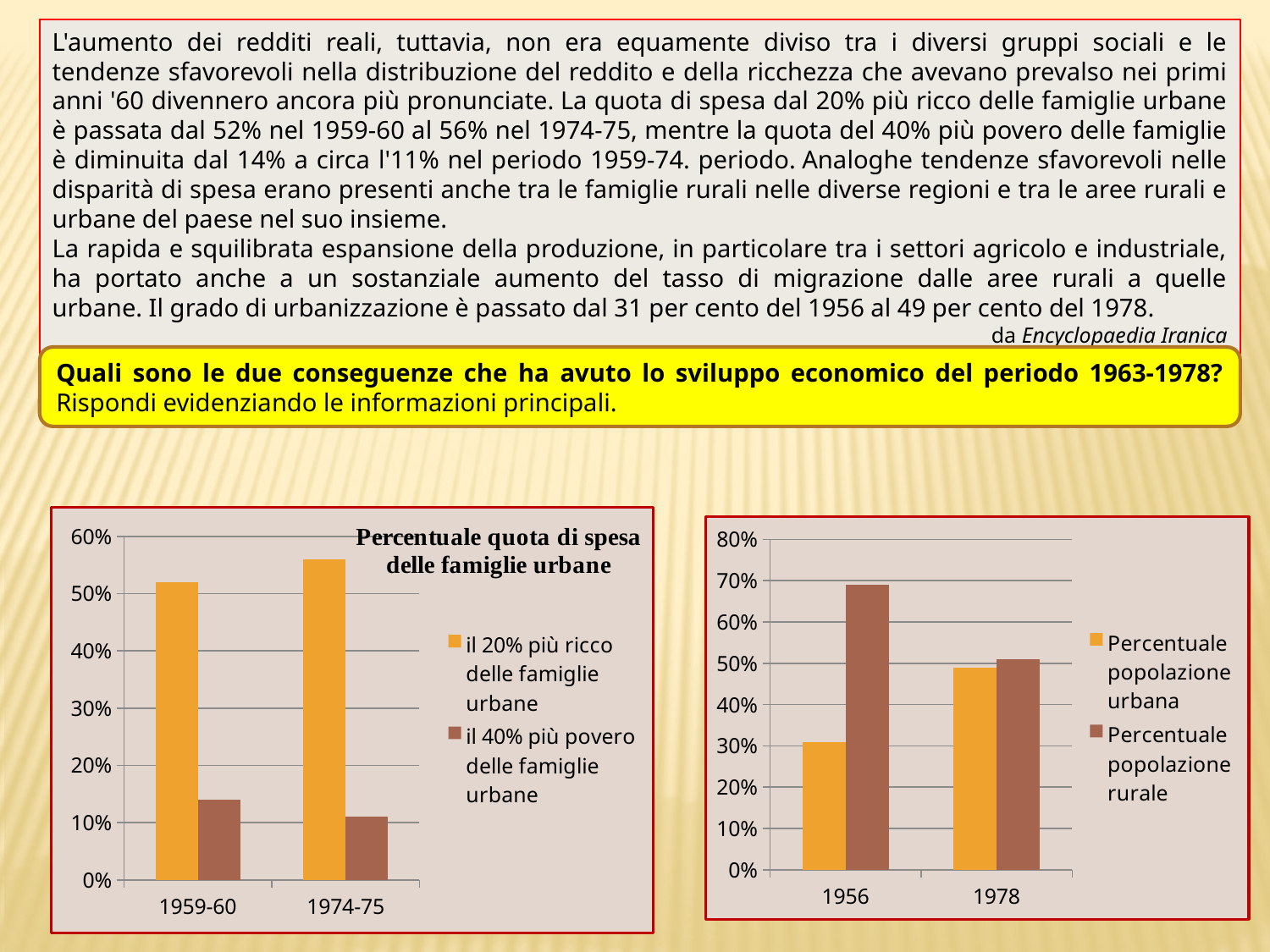
What is the title of the chart on the left? Percentuale quota di spesa delle famiglie urbane In the left chart, is the value for 'il 40% più povero delle famiglie urbane' in 1959-60 greater or less than 20%? less How many categories are shown on the x axis of the left chart? 2 In the chart on the right, which series has the higher value in 1956, 'Percentuale popolazione urbana' or 'Percentuale popolazione rurale'? Percentuale popolazione rurale In the chart on the right, is the value for 'Percentuale popolazione rurale' in 1956 greater or less than 60%? greater In the left chart, does the value for 'il 40% più povero delle famiglie urbane' rise or fall from 1959-60 to 1974-75? fall What kind of chart is the chart on the left? bar chart How many series does the legend of the chart on the right list? 2 How many series does the legend of the left chart list? 2 In the chart on the right, is the value for 'Percentuale popolazione urbana' in 1956 greater or less than 40%? less In the left chart, which category has the higher value for 'il 20% più ricco delle famiglie urbane', 1959-60 or 1974-75? 1974-75